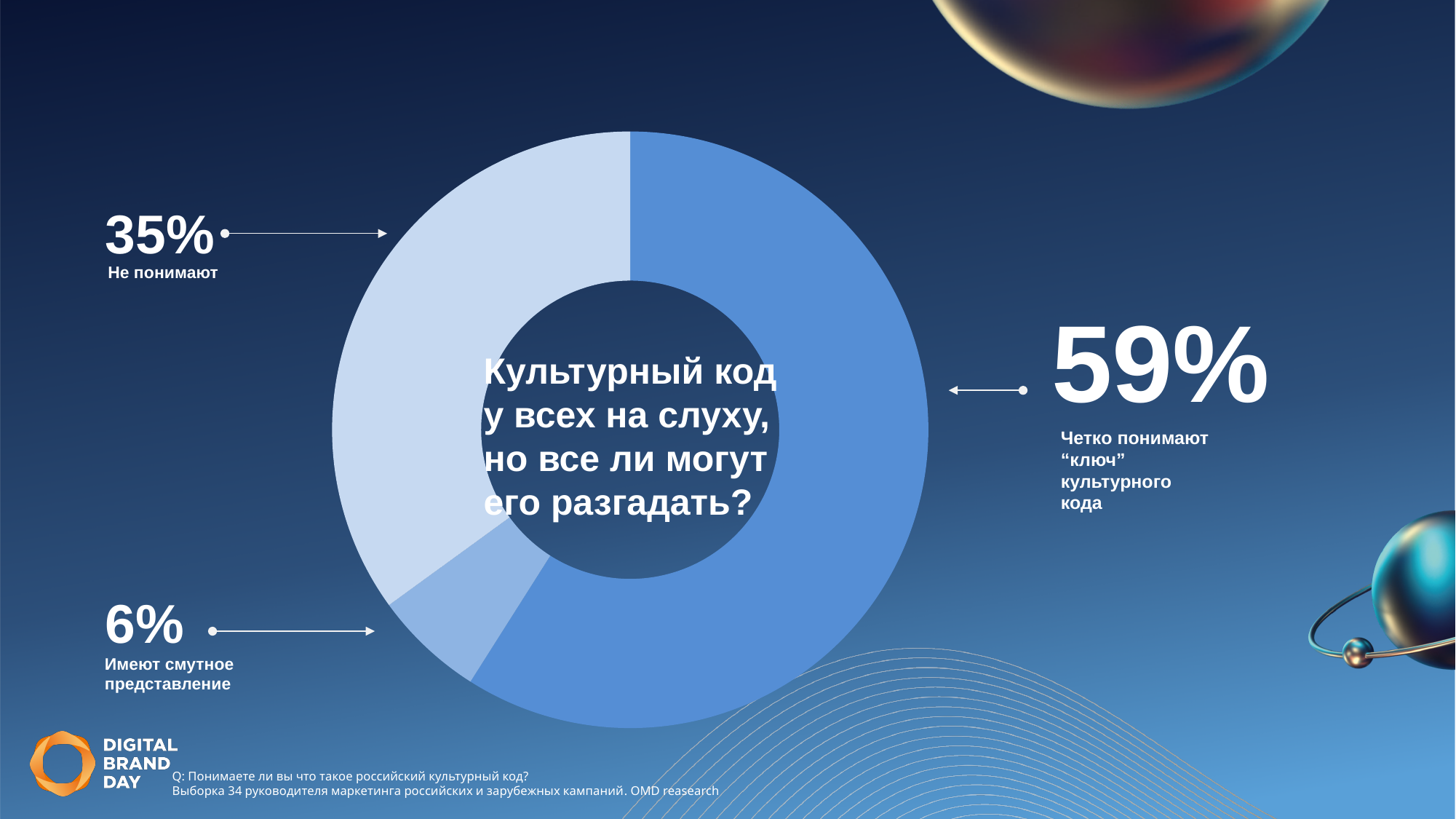
How many categories are shown in the donut chart? 3 What is the difference in percentage points between the share that do not understand (35%) and the share with a vague idea (6%)? 29 What is the difference in percentage points between the share that clearly understand (59%) and the share that do not understand (35%)? 24 What share of respondents do not understand (Не понимают) the cultural code? 35% What share of respondents clearly understand the "key" of the cultural code (Четко понимают "ключ" культурного кода)? 59% Which category has the smallest share of the donut chart? Имеют смутное представление Which category has the largest share of the donut chart? Четко понимают "ключ" культурного кода What is the combined share of the two categories that do not clearly understand the cultural code (35% and 6%)? 41% What kind of chart is shown on the slide? Donut (pie) chart Which is larger: the share that do not understand or the share with a vague idea? Не понимают What share of respondents have a vague idea (Имеют смутное представление)? 6% What text is written in the centre of the donut chart? Культурный код у всех на слуху, но все ли могут его разгадать?